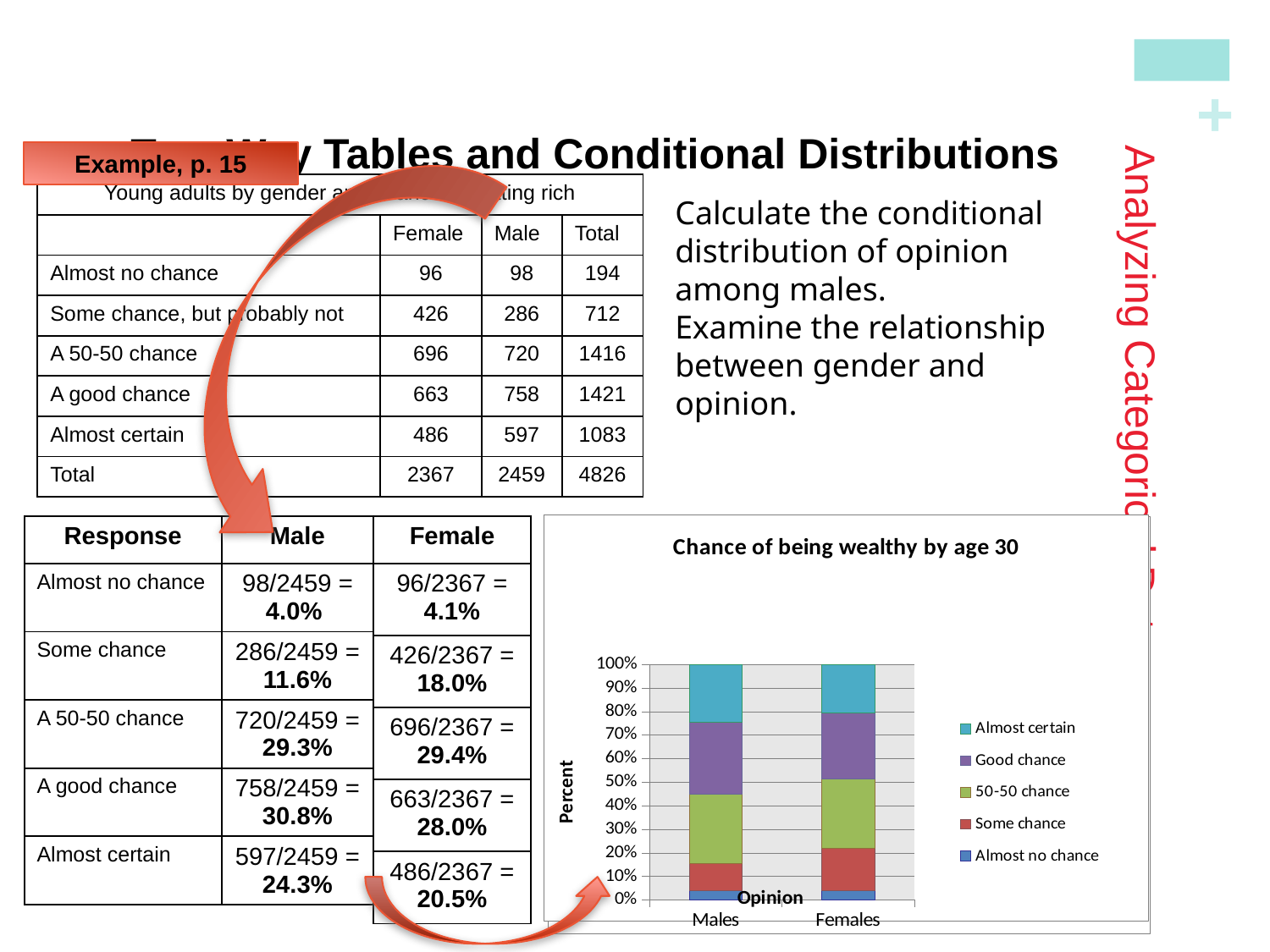
What kind of chart is shown on the slide? bar chart Is the Some chance value for Males greater or less than 20%? less Is the Some chance value for Females greater or less than 10%? greater Is the Almost certain value for Females greater or less than 10%? greater How many series does the chart's legend list? 5 In the chart, is the Some chance segment larger for Males or for Females? Females What is the title of the chart? Chance of being wealthy by age 30 How many categories are plotted along the x axis of the chart? 2 In the chart, is the Almost certain segment larger for Males or for Females? Males What is the label on the chart's vertical axis? Percent